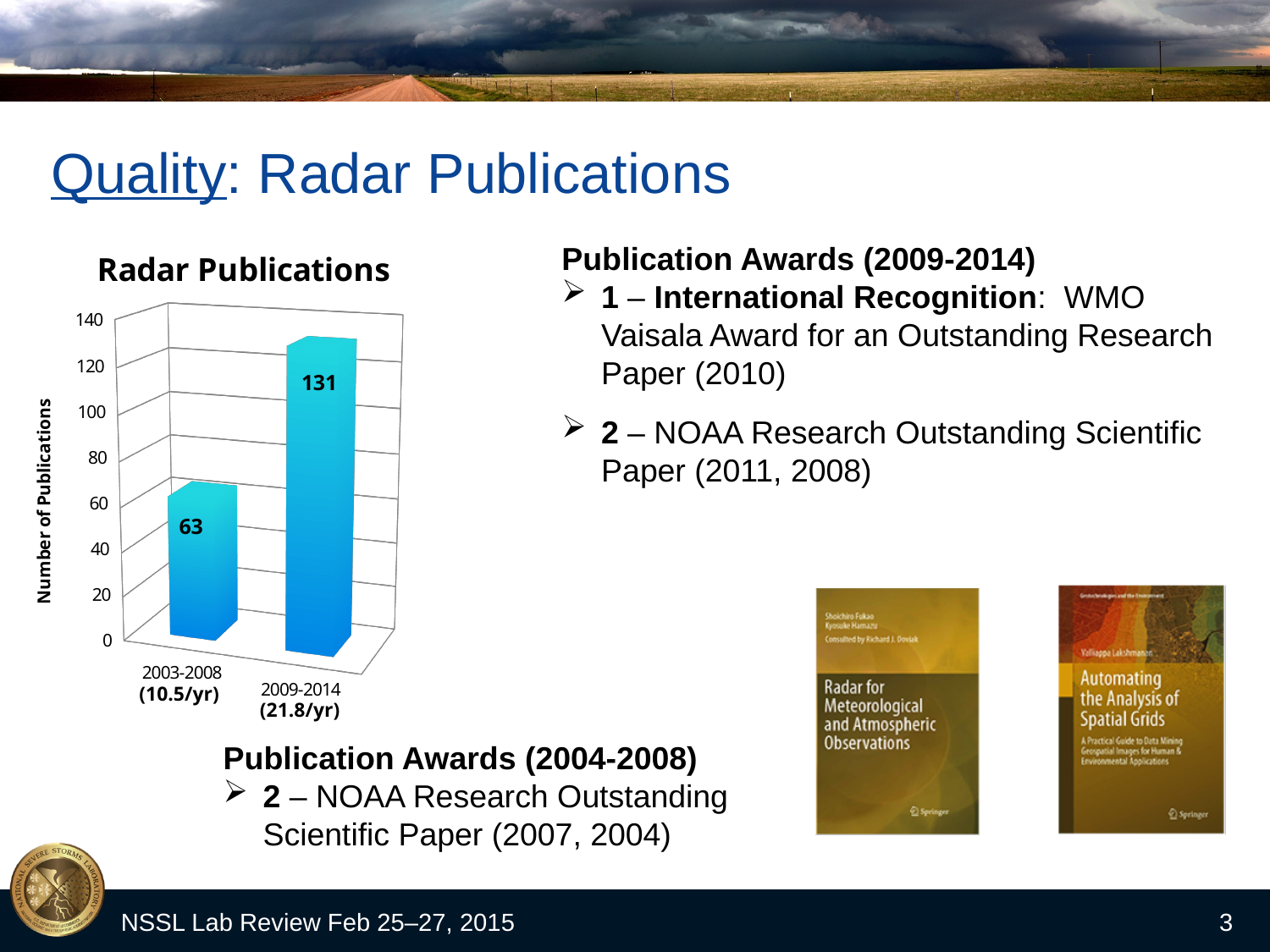
What type of chart is the Radar Publications chart? bar chart What is the number of radar publications for 2003-2008? 63 What is the y-axis label of the Radar Publications chart? Number of Publications Do radar publications rise or fall from 2003-2008 to 2009-2014? rise What is the number of radar publications for 2009-2014? 131 How many periods are shown in the Radar Publications chart? 2 Is the number of radar publications for 2003-2008 greater or less than 80? less Is the number of radar publications for 2009-2014 greater or less than 120? greater What is the title of the chart? Radar Publications What is the difference in radar publications between 2009-2014 and 2003-2008? 68 Which period has the lower number of radar publications? 2003-2008 Which period has the higher number of radar publications? 2009-2014